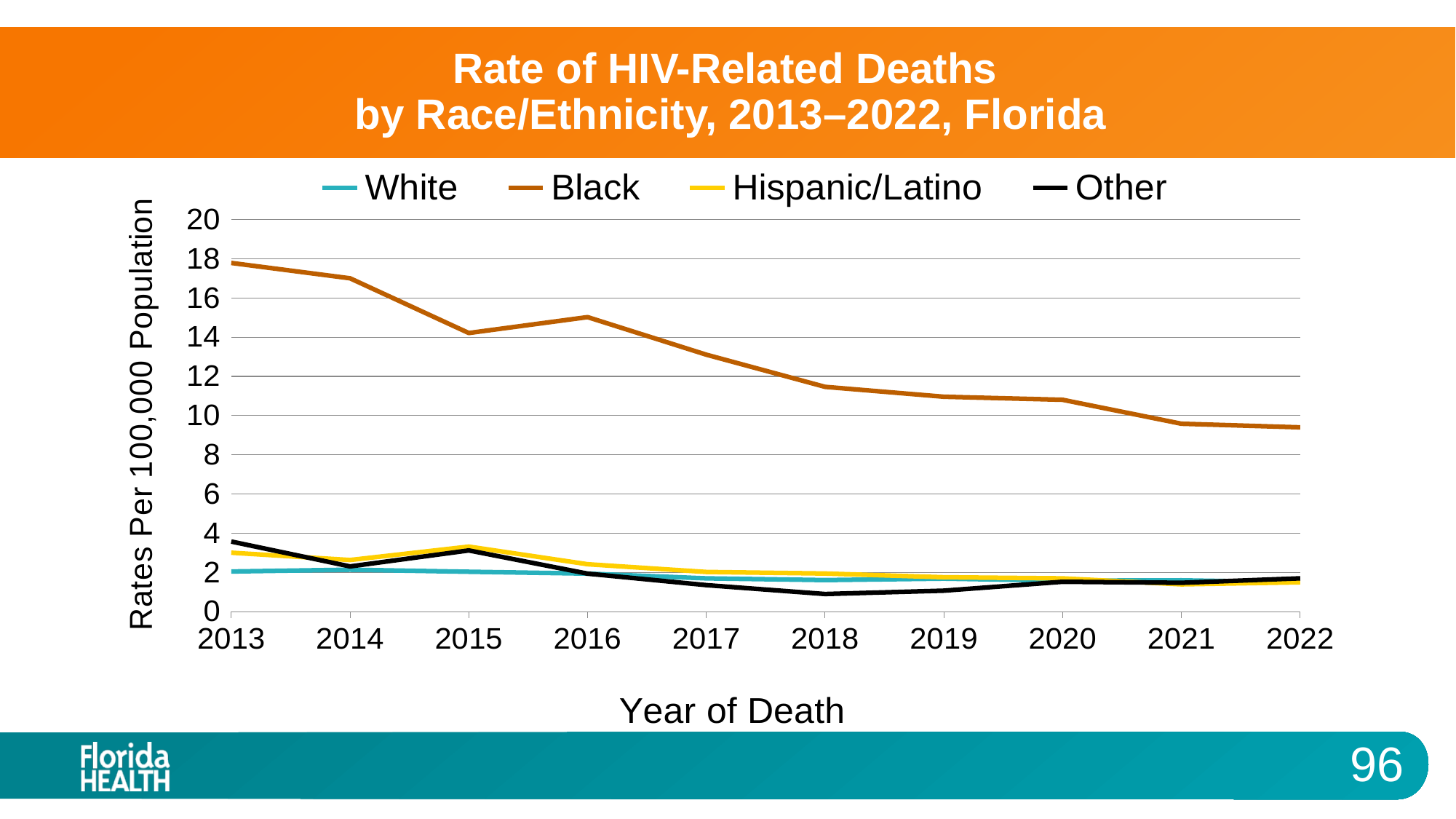
What is the label on the y axis of the chart? Rates Per 100,000 Population Which race/ethnicity group has the highest rate of HIV-related deaths in 2013? Black How many series does the legend list? 4 Is the rate for the Other group in 2018 greater or less than 2? less Is the rate for the Black group in 2022 greater or less than 10? less Does the rate for the Black group generally rise or fall from 2013 to 2022? Fall In which year is the rate for the Other group lowest? 2018 Is the rate for the Black group in 2013 greater or less than 16? greater In which year is the rate for the Black group highest? 2013 What kind of chart is shown on the slide? Line chart In 2013, which is larger: the rate for the Other group or the rate for the White group? Other How many years are shown on the x axis? 10